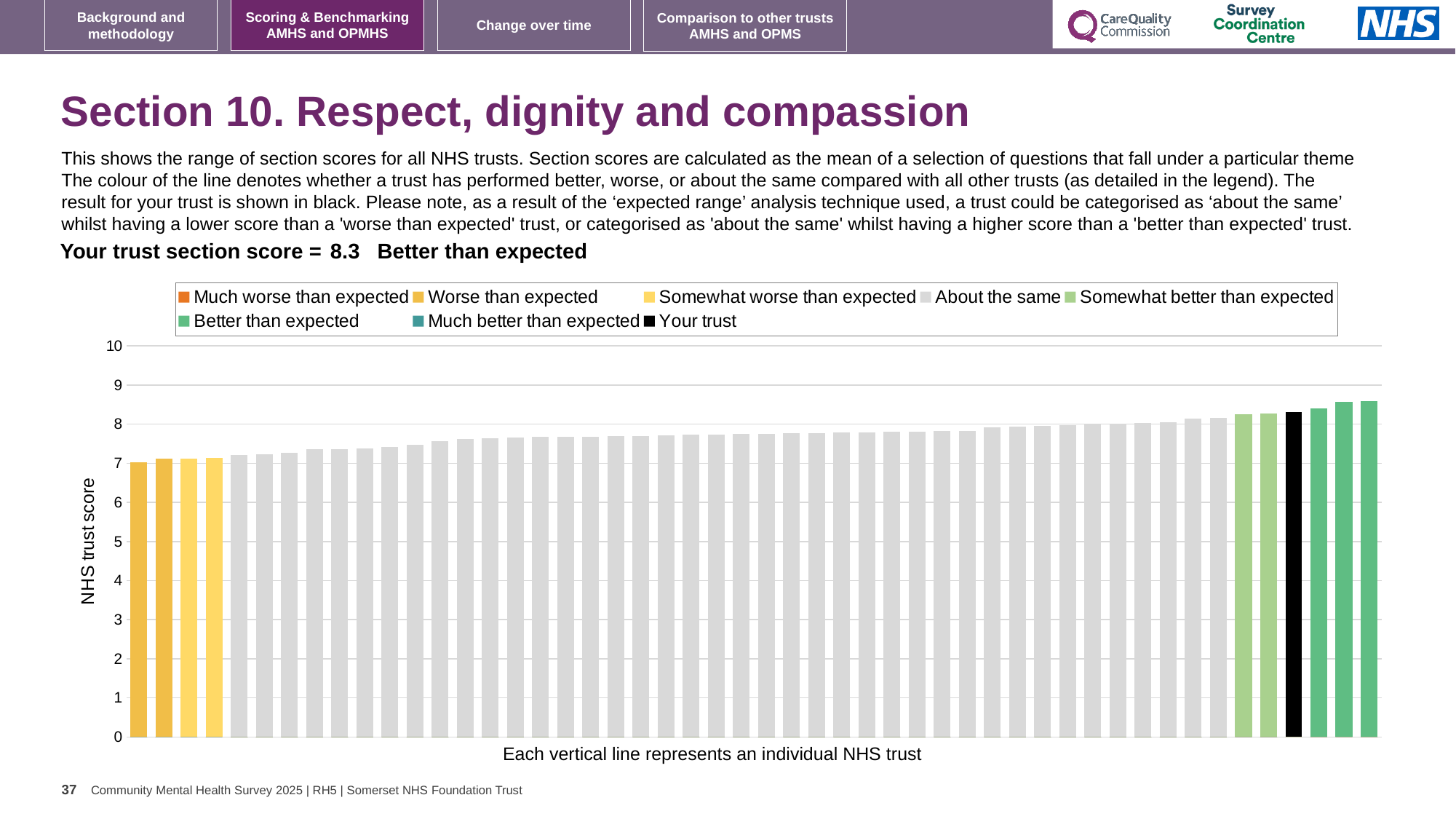
What is the label on the y axis of the chart? NHS trust score Is the value of the rightmost (highest) bar greater or less than 9? less How many bars are coloured in the 'Better than expected' green to the right of the black bar? 3 Is the value of the black 'Your trust' bar greater or less than 8? greater What colour is the bar representing your trust? black How many entries does the chart legend list? 8 Do the bar values rise or fall from left to right along the x axis? rise Is the value of the leftmost bar greater or less than 8? less Which is higher, the black 'Your trust' bar or the leftmost bar? the black 'Your trust' bar What kind of chart is shown on the slide? bar chart What is the section score for your trust shown on the slide? 8.3